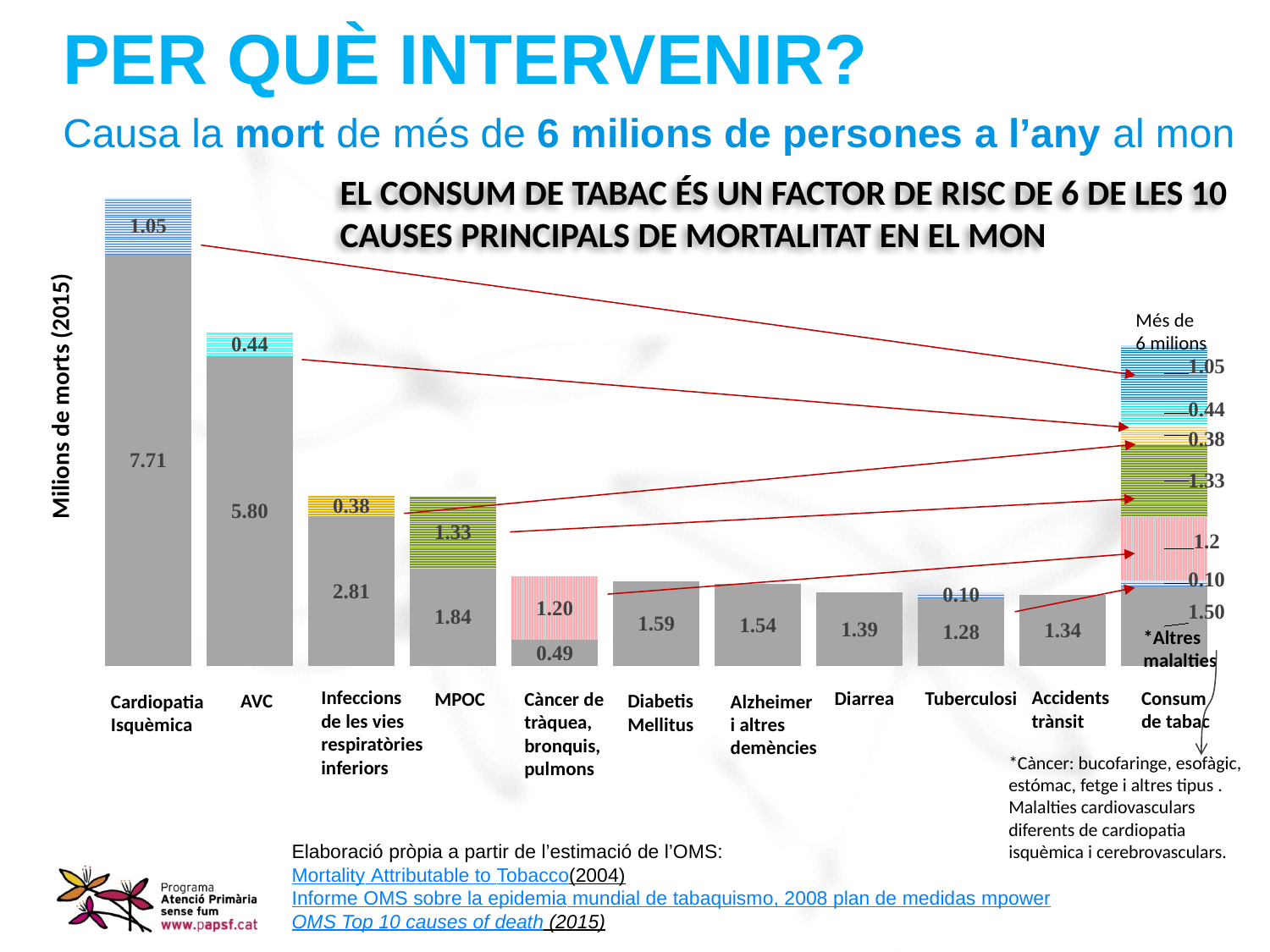
What kind of chart is shown on the slide? Bar chart What is the difference between the grey segment of Cardiopatia Isquèmica (7.71) and the grey segment of AVC (5.80)? 1.91 What value is shown for Diabetis Mellitus? 1.59 What is the label on the vertical axis of the chart? Milions de morts (2015) What is the total of the Càncer de tràquea, bronquis, pulmons bar (0.49 plus 1.20)? 1.69 Which cause of death has the largest grey segment? Cardiopatia Isquèmica What is the value of the grey (non-tobacco) segment for Cardiopatia Isquèmica? 7.71 Which is larger, the value for Alzheimer i altres demències or the value for Diarrea? Alzheimer i altres demències Which cause of death has the smallest tobacco-attributable segment? Tuberculosi What is the value labelled '*Altres malalties' in the Consum de tabac bar? 1.50 What is the tobacco-attributable value shown on the Tuberculosi bar? 0.10 What is the tobacco-attributable value shown on top of the MPOC bar? 1.33